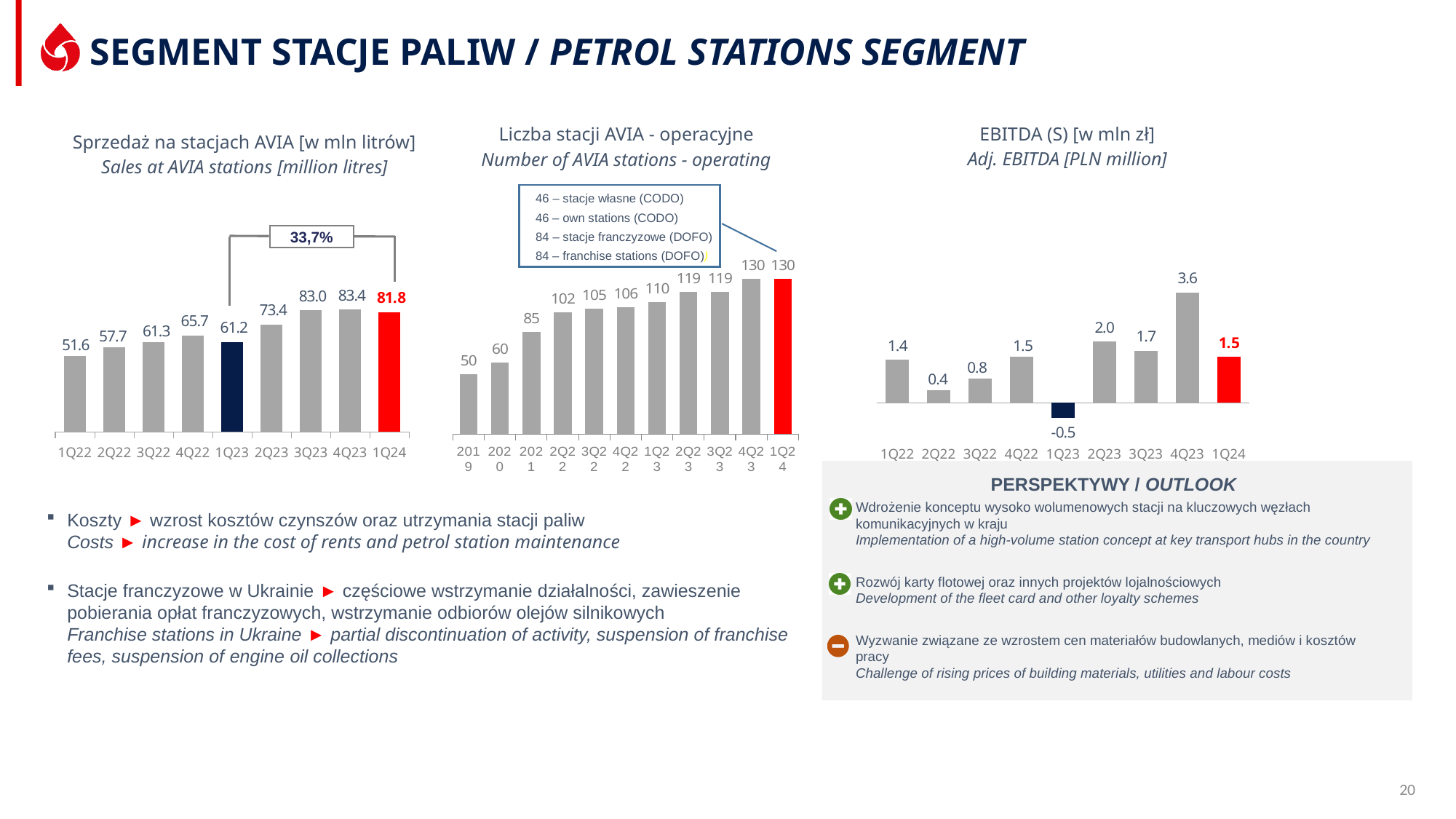
In the 'Sales at AVIA stations [million litres]' chart, which quarter has the highest value? 4Q23 In the 'Number of AVIA stations - operating' chart, what is the value for 2021? 85 In the 'Sales at AVIA stations [million litres]' chart, what is the value for 1Q24? 81.8 What type of chart is the 'Adj. EBITDA [PLN million]' chart? bar chart In the 'Sales at AVIA stations [million litres]' chart, what percentage change is shown in the box above the bars? 33,7% In the 'Sales at AVIA stations [million litres]' chart, which quarter has the lowest value? 1Q22 In the 'Number of AVIA stations - operating' chart, how many own stations (CODO) are listed in the callout box? 46 In the 'Number of AVIA stations - operating' chart, how many bars are plotted? 11 In the 'Adj. EBITDA [PLN million]' chart, which quarter has the highest value? 4Q23 In the 'Adj. EBITDA [PLN million]' chart, what is the value for 1Q23? -0.5 In the 'Sales at AVIA stations [million litres]' chart, what is the difference between 2Q23 and 1Q23? 12.2 In the 'Number of AVIA stations - operating' chart, do the values generally rise or fall from left to right? rise